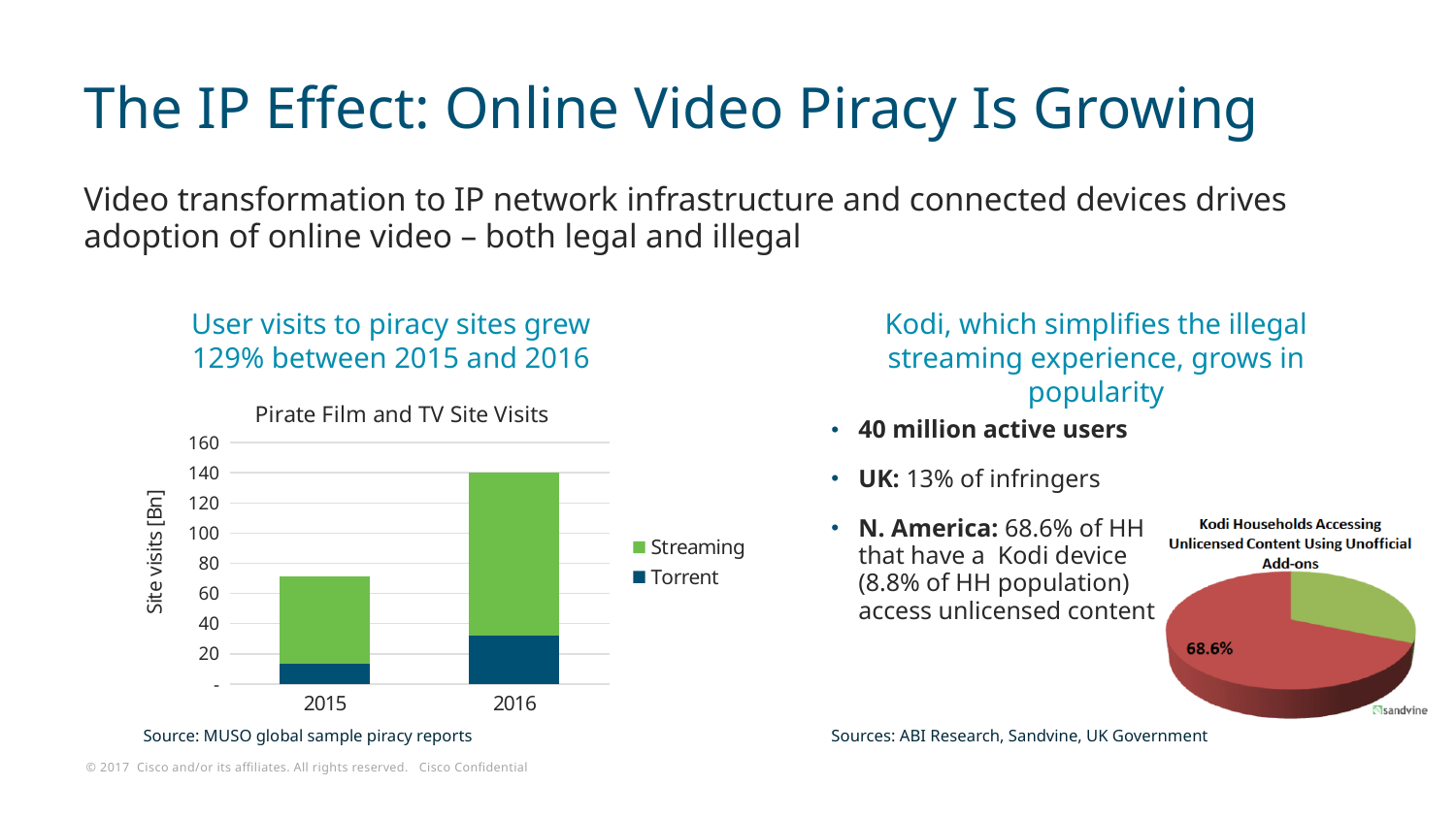
In the 'Kodi Households Accessing Unlicensed Content Using Unofficial Add-ons' chart, what share of the pie is labelled for the red slice? 68.6% In the 'Pirate Film and TV Site Visits' chart, what kind of chart is shown? Bar chart In the 'Pirate Film and TV Site Visits' chart, which year has the larger total of site visits, 2015 or 2016? 2016 What kind of chart is the 'Kodi Households Accessing Unlicensed Content Using Unofficial Add-ons' chart? Pie chart In the 'Pirate Film and TV Site Visits' chart, is the total value for 2016 greater or less than 120? greater In the 'Pirate Film and TV Site Visits' chart, what are the two series named in the legend? Streaming and Torrent In the 'Pirate Film and TV Site Visits' chart, what is the label on the y axis? Site visits [Bn] In the 'Pirate Film and TV Site Visits' chart, how many years are shown on the x axis? 2 In the 'Pirate Film and TV Site Visits' chart, is the Torrent value for 2015 greater or less than 20? less In the 'Pirate Film and TV Site Visits' chart, is the total value for 2015 greater or less than 100? less In the 'Pirate Film and TV Site Visits' chart, do total site visits rise or fall from 2015 to 2016? Rise In the 'Pirate Film and TV Site Visits' chart, how many series does the legend list? 2